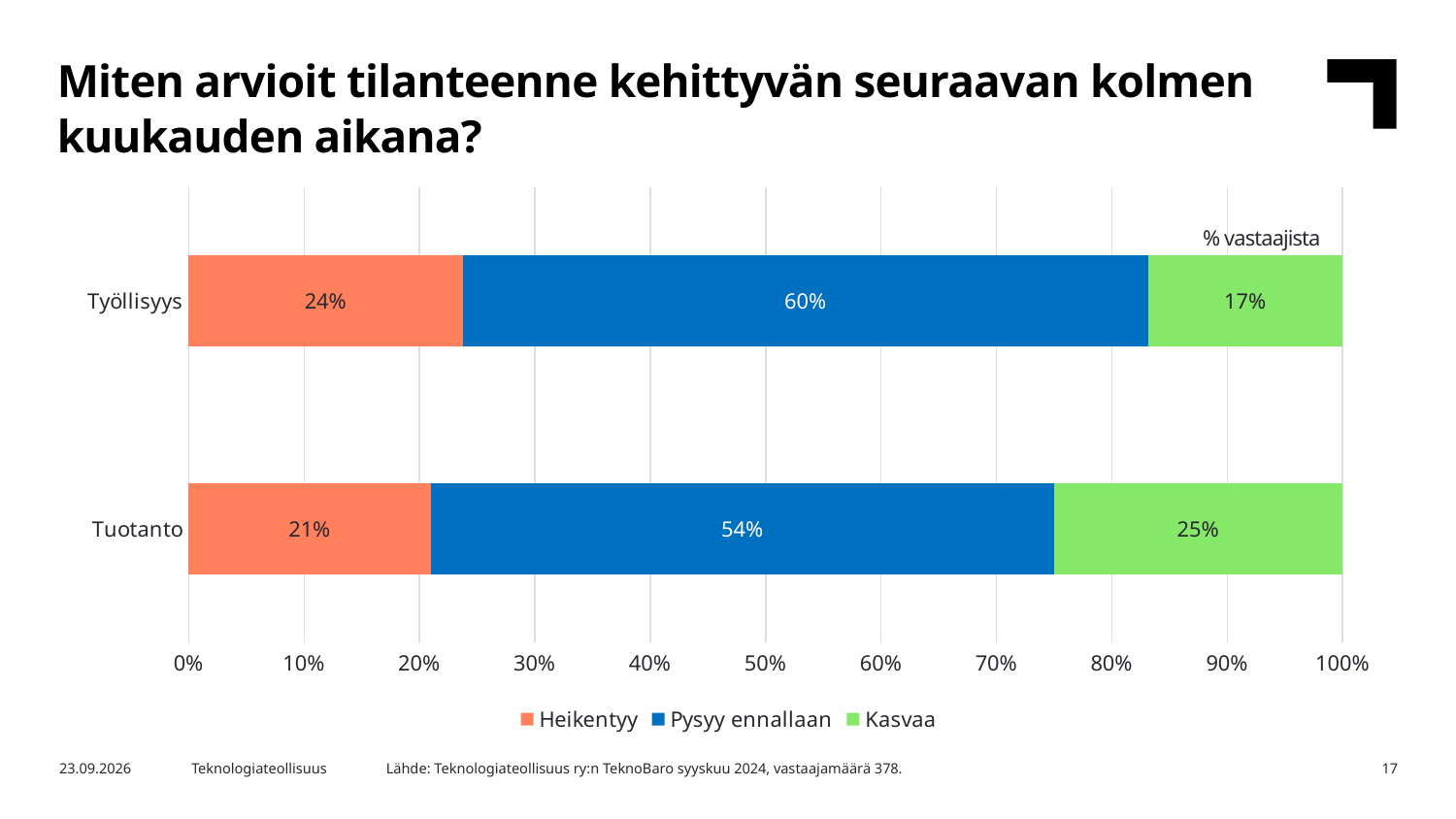
What is the 'Heikentyy' value for Tuotanto? 21% Which legend entry is shown in green? Kasvaa What is the difference between the 'Kasvaa' values for Tuotanto and Työllisyys? 8 percentage points What kind of chart is shown on the slide? Stacked bar chart What is the 'Heikentyy' value for Työllisyys? 24% What is the 'Kasvaa' value for Tuotanto? 25% What is the total of the stacked bar for Tuotanto? 100% What percentage of respondents expect Työllisyys to 'Pysyy ennallaan'? 60% Which category has the higher 'Kasvaa' share, Työllisyys or Tuotanto? Tuotanto How many categories are shown on the chart? 2 What is the difference between the 'Pysyy ennallaan' values for Työllisyys and Tuotanto? 6 percentage points How many series does the legend list? 3